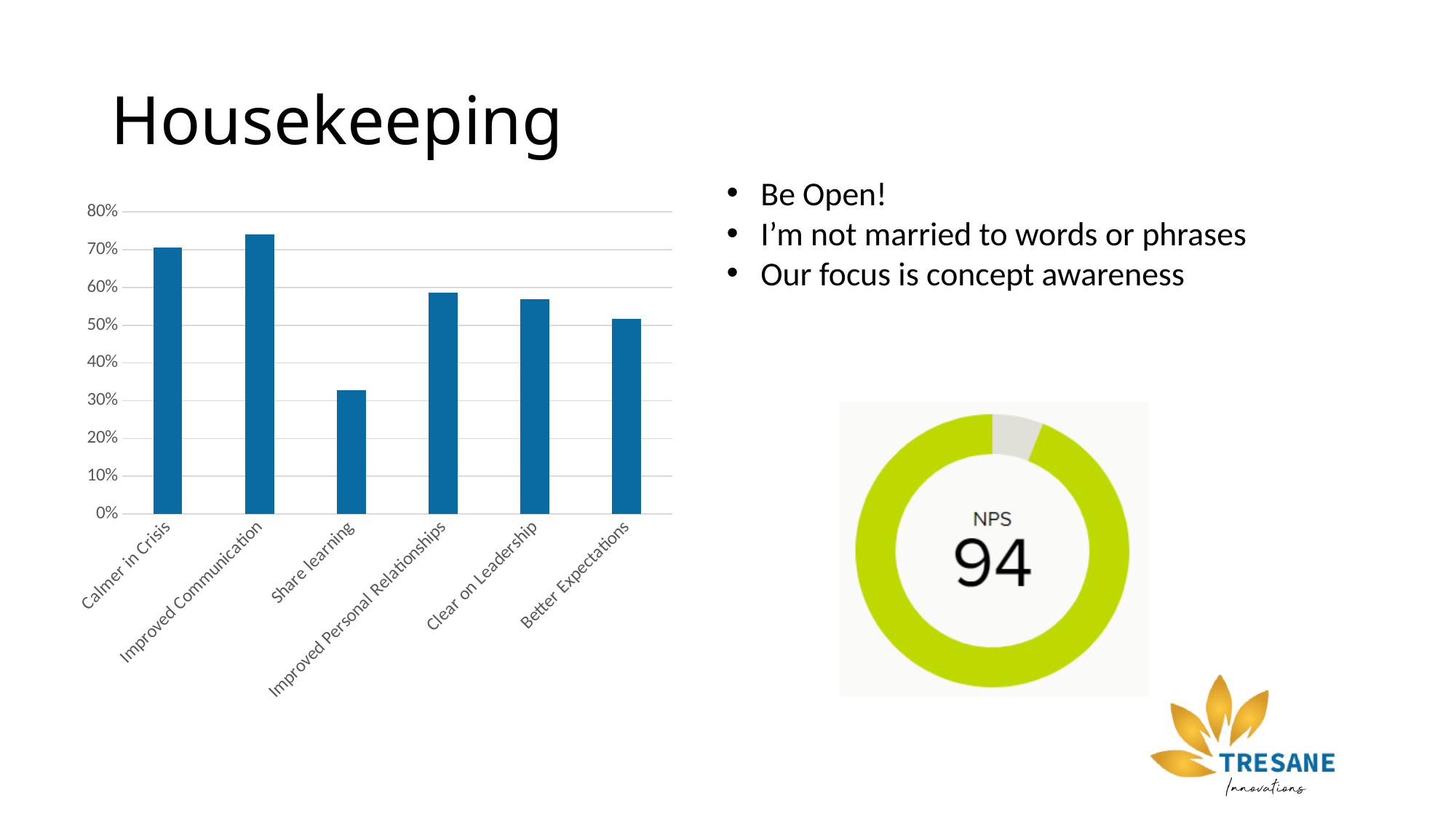
In the bar chart, is the value for Share learning greater or less than 40%? less In the bar chart, is the value for Clear on Leadership greater or less than 60%? less What kind of chart is shown on the left of the slide? bar chart In the bar chart, which is larger: the value for Calmer in Crisis or the value for Improved Personal Relationships? Calmer in Crisis In the bar chart, is the value for Better Expectations greater or less than 60%? less Which category has the highest bar in the bar chart? Improved Communication What NPS value is shown in the circular gauge on the right of the slide? 94 Which category has the lowest bar in the bar chart? Share learning In the bar chart, which is larger: the value for Share learning or the value for Better Expectations? Better Expectations How many categories does the bar chart show? 6